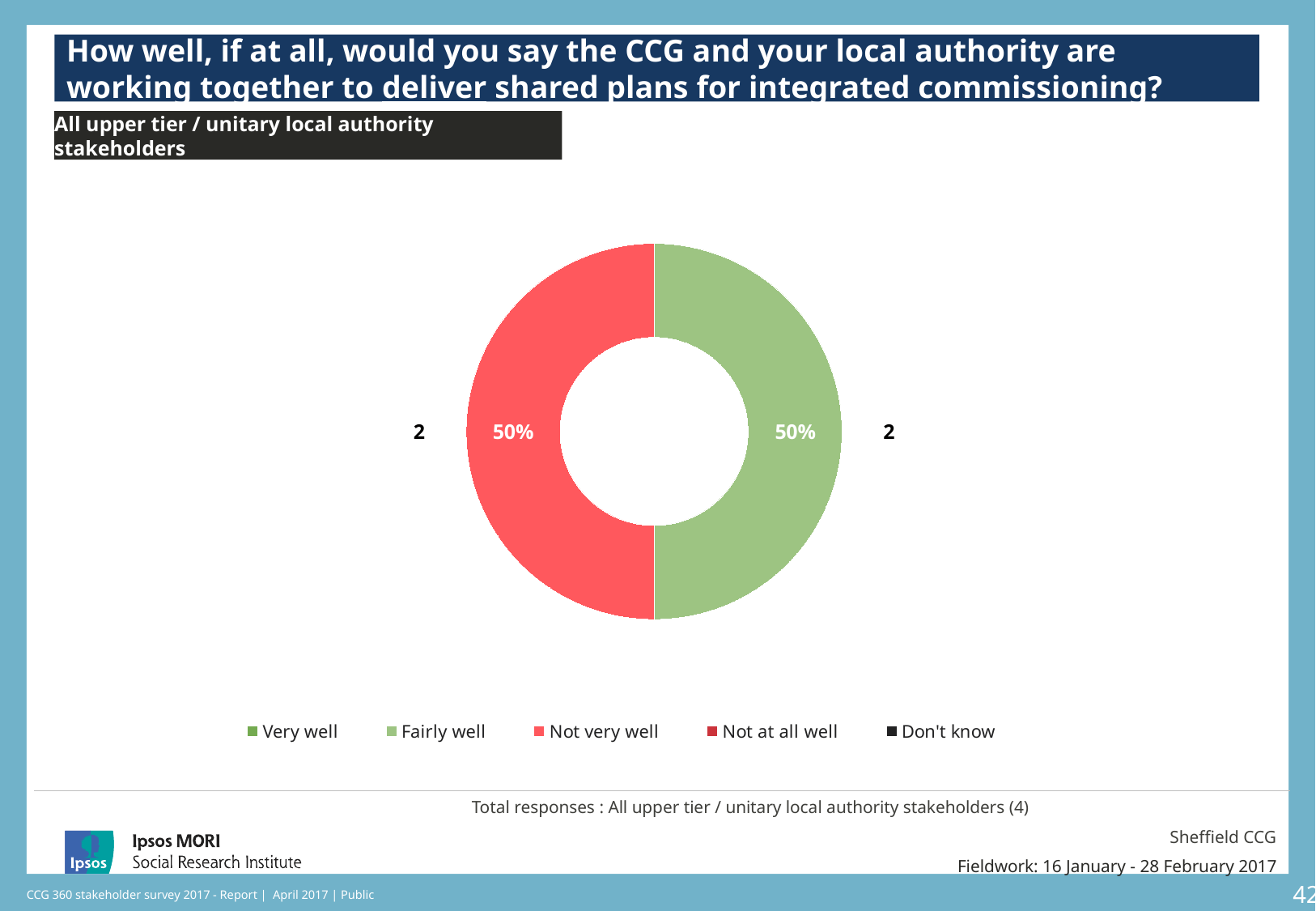
Which legend category is shown in black? Don't know Is the share for 'Fairly well' larger than, smaller than, or equal to the share for 'Not very well'? Equal How many response categories does the legend list? 5 How many respondents answered 'Fairly well', according to the number printed next to the slice? 2 Which stakeholder group does the chart cover, according to the label above it? All upper tier / unitary local authority stakeholders How many slices are visible in the donut chart? 2 Is the share for 'Not very well' greater or less than 25%? greater How many respondents answered 'Not very well', according to the number printed next to the slice? 2 What percentage of the chart is the 'Fairly well' slice? 50% What percentage of the chart is the 'Not very well' slice? 50% What kind of chart is shown on the slide? Pie (donut) chart What is the total number of responses stated below the chart? 4